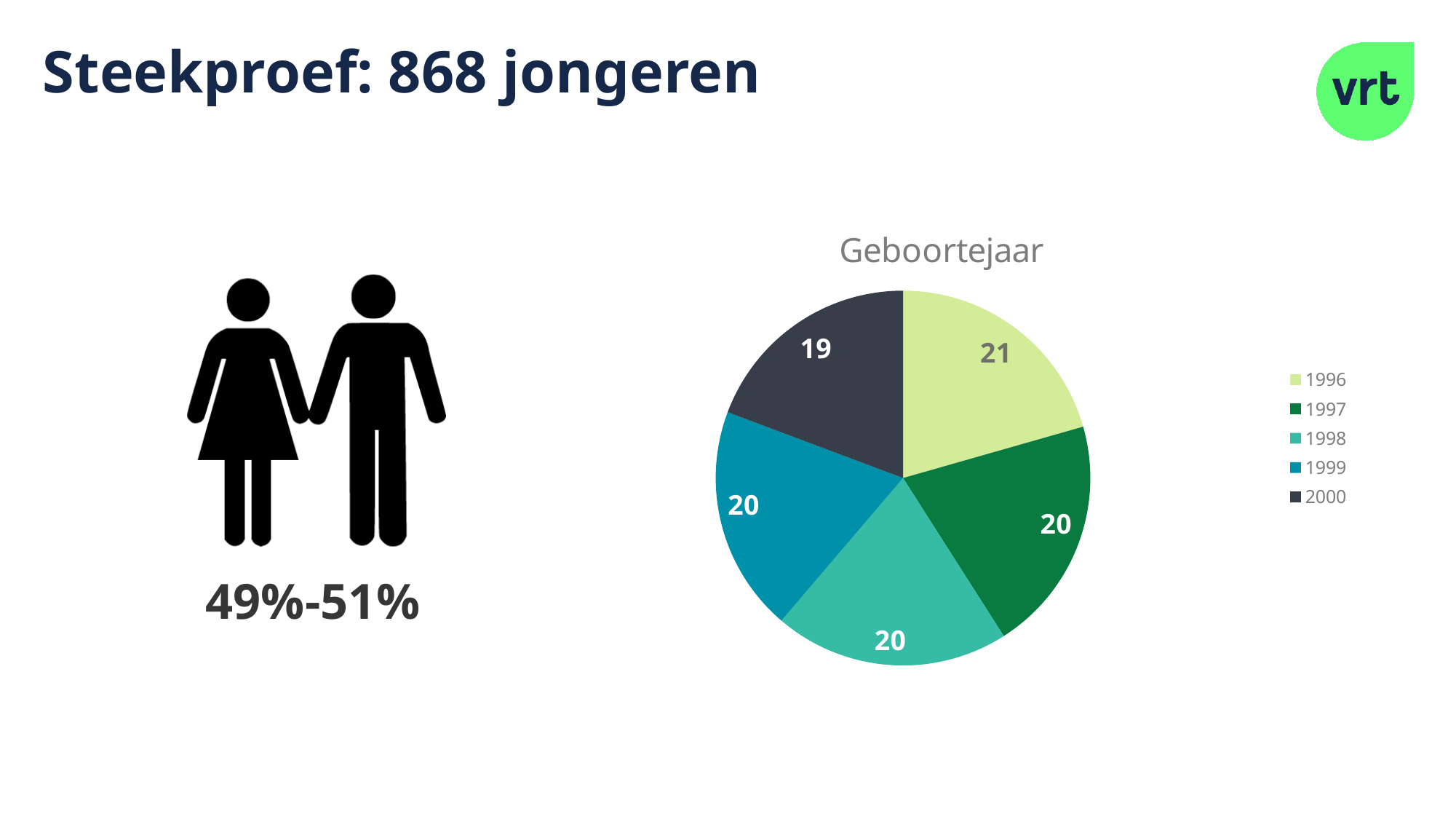
What kind of chart is shown under the title 'Geboortejaar'? pie chart In the 'Geboortejaar' pie chart, which is larger, the value for 1996 or the value for 2000? 1996 What is the difference between the values for 1996 and 2000 in the 'Geboortejaar' pie chart? 2 What is the value for 2000 in the 'Geboortejaar' pie chart? 19 What is the title of the pie chart? Geboortejaar How many entries does the legend of the 'Geboortejaar' pie chart list? 5 Which birth year has the smallest slice in the 'Geboortejaar' pie chart? 2000 How many slices does the 'Geboortejaar' pie chart have? 5 Which birth year has the largest slice in the 'Geboortejaar' pie chart? 1996 Which legend entry in the 'Geboortejaar' pie chart is shown in the darkest colour? 2000 What is the value for 1998 in the 'Geboortejaar' pie chart? 20 What is the value for 1996 in the 'Geboortejaar' pie chart? 21